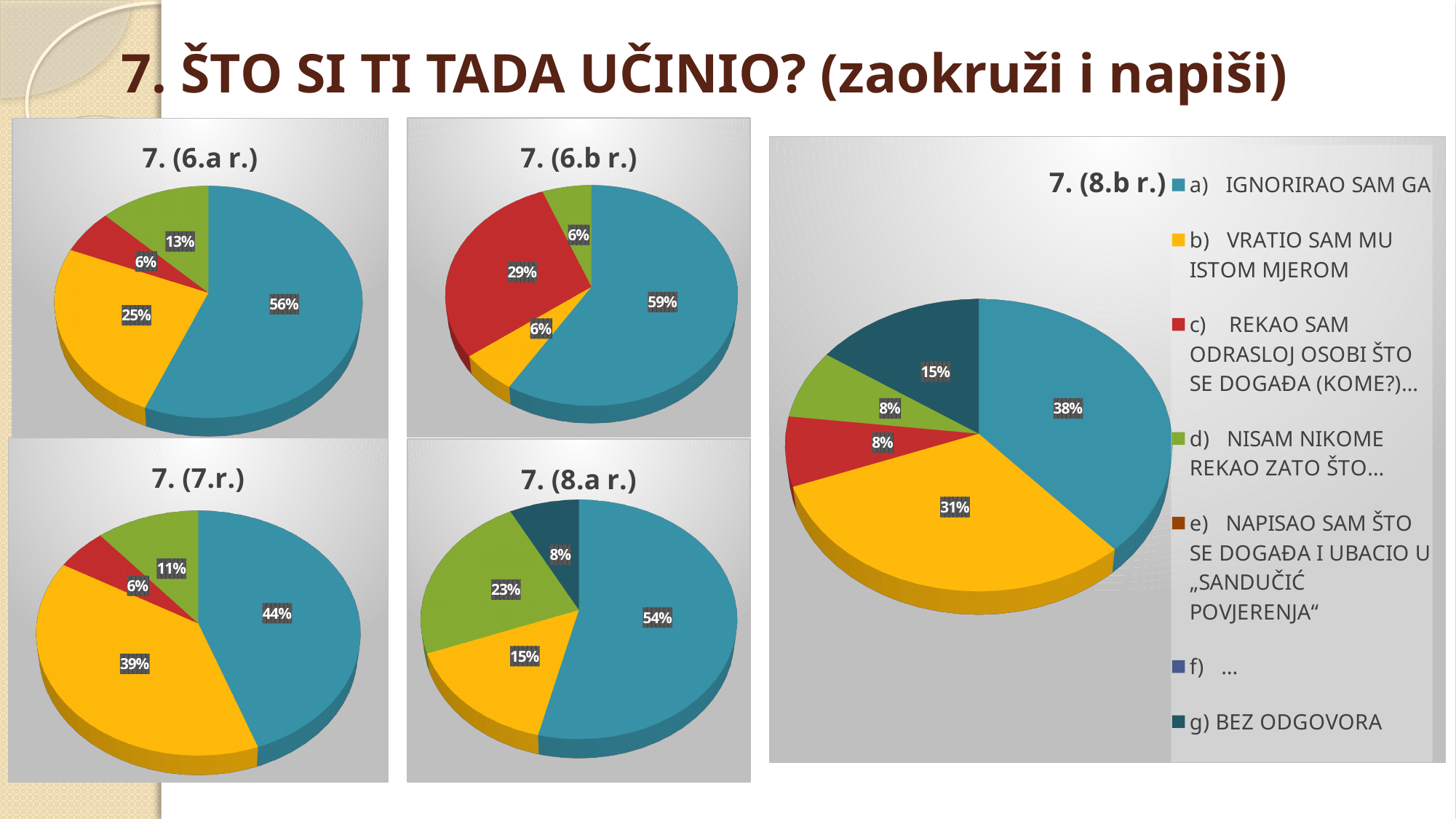
How many entries does the legend of the chart titled 7. (8.b r.) list? 7 Which chart has the larger yellow slice: 7. (7.r.) or 7. (8.b r.)? 7. (7.r.) In the chart titled 7. (8.b r.), what percentage is shown for g) BEZ ODGOVORA? 15% In the chart titled 7. (8.b r.), what percentage is shown for b) VRATIO SAM MU ISTOM MJEROM? 31% In the chart titled 7. (8.b r.), which legend category has the largest slice? a) IGNORIRAO SAM GA How many pie charts are shown on the slide? 5 In the chart titled 7. (8.a r.), what percentage is shown on the green slice? 23% In the chart titled 7. (7.r.), what is the difference between the blue slice (44%) and the yellow slice (39%)? 5% In the chart titled 7. (6.b r.), what percentage is shown on the red slice? 29% What type of chart is used for 7. (7.r.)? Pie chart In the chart titled 7. (8.b r.), what share of the pie is a) IGNORIRAO SAM GA? 38% In the chart titled 7. (6.a r.), what is the value of the largest slice? 56%